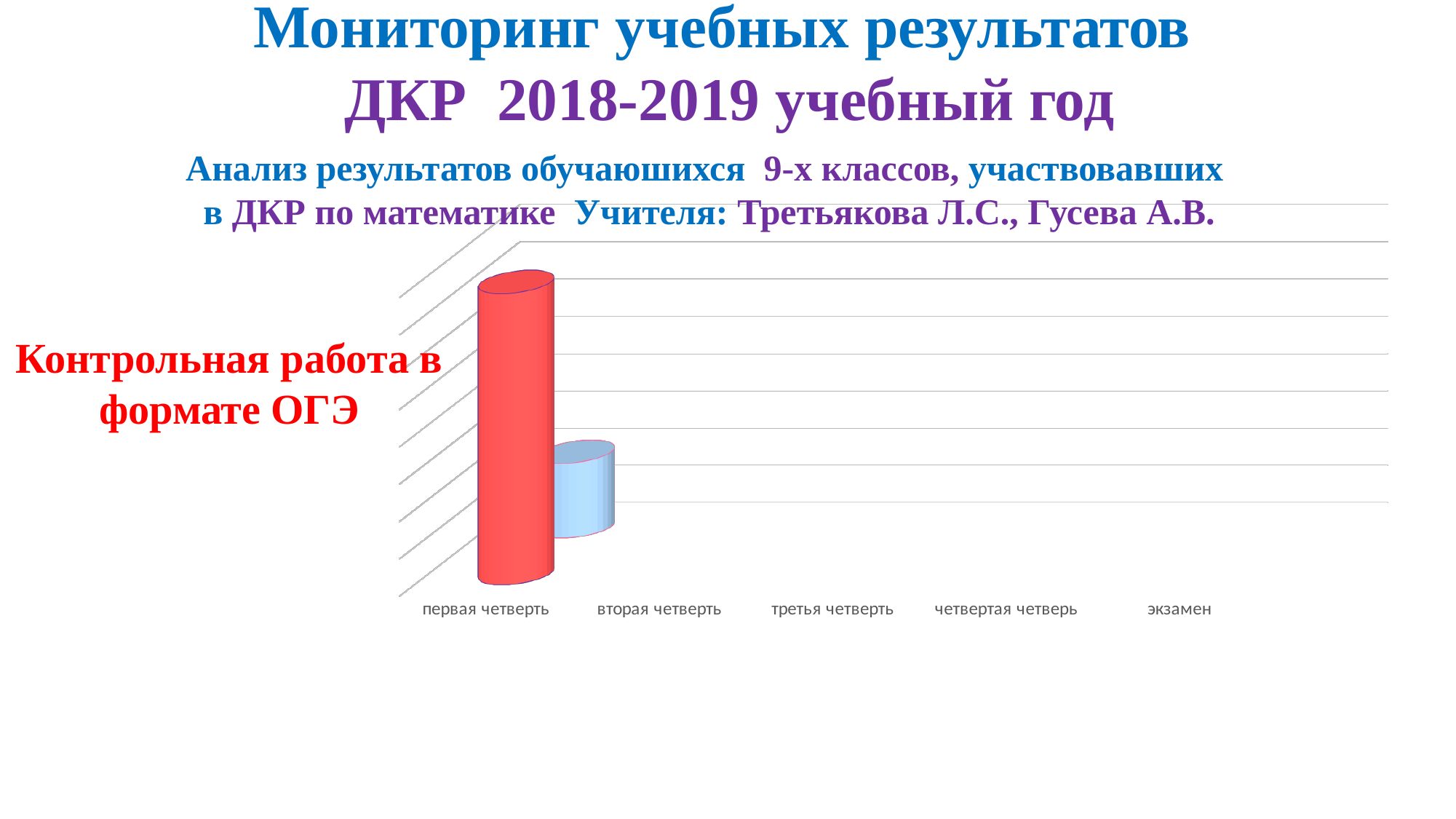
Which category has the highest bar in the chart? первая четверть How many categories are labelled on the x axis of the chart? 5 How many bars are actually plotted in the chart? 2 What is the label of the last category on the x axis? экзамен What kind of chart is shown on the slide? bar chart